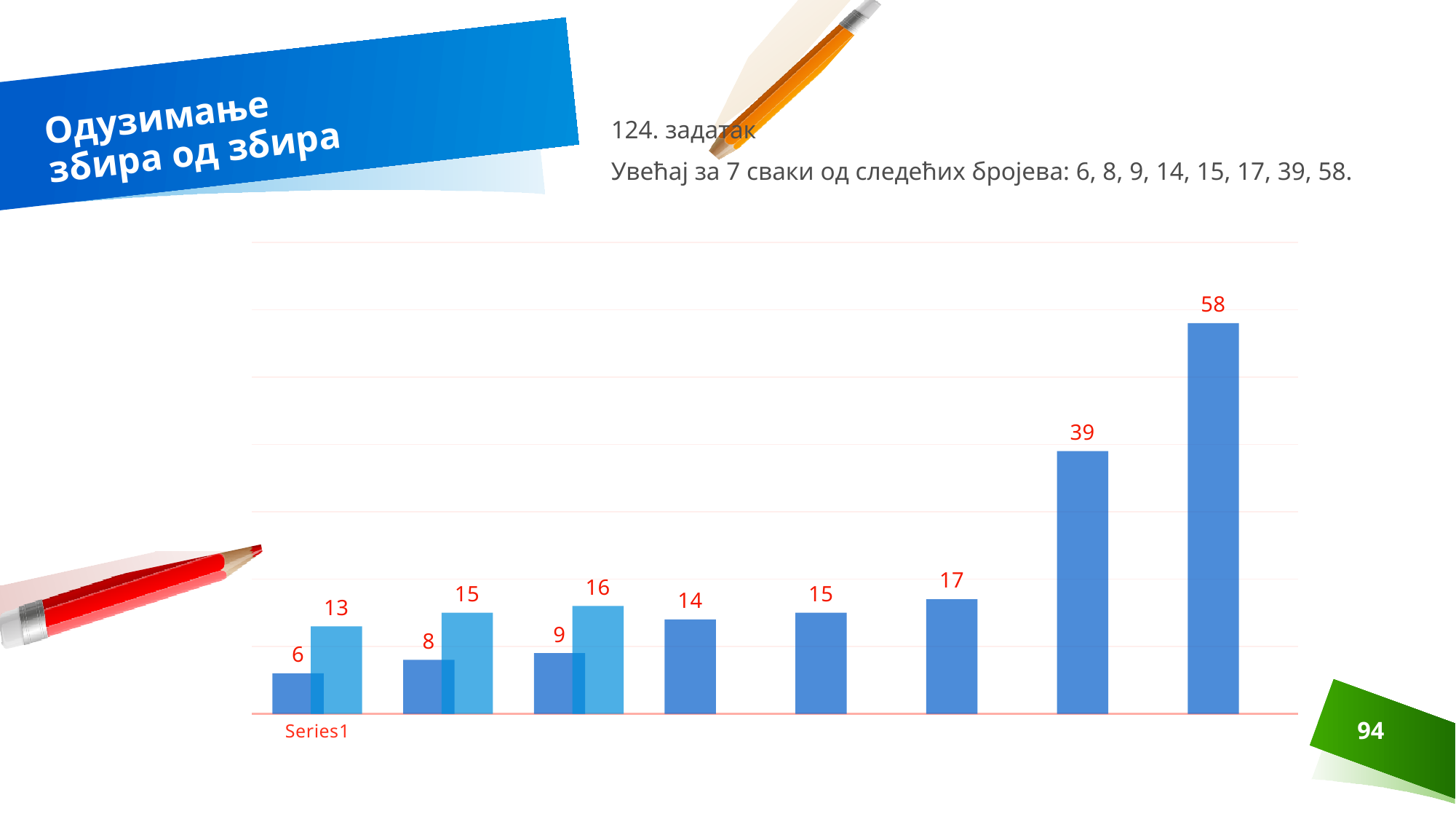
How many dark blue bars are plotted in the chart? 8 Do the values of the dark blue bars rise or fall from left to right? rise What is the value labelled on the fourth dark blue bar from the left? 14 What is the value of the tallest bar in the chart? 58 What is the value labelled on the seventh dark blue bar from the left? 39 What is the value of the shortest dark blue bar in the chart? 6 What is the difference between the values of the two tallest bars (58 and 39)? 19 What category label is printed under the first bar on the x axis? Series1 Which is larger: the value of the seventh dark blue bar or the eighth dark blue bar? the eighth bar (58) What kind of chart is shown on the slide? bar chart What is the difference between the sixth dark blue bar (17) and the fifth dark blue bar (15)? 2 What value is labelled on the light blue bar next to the first dark blue bar? 13